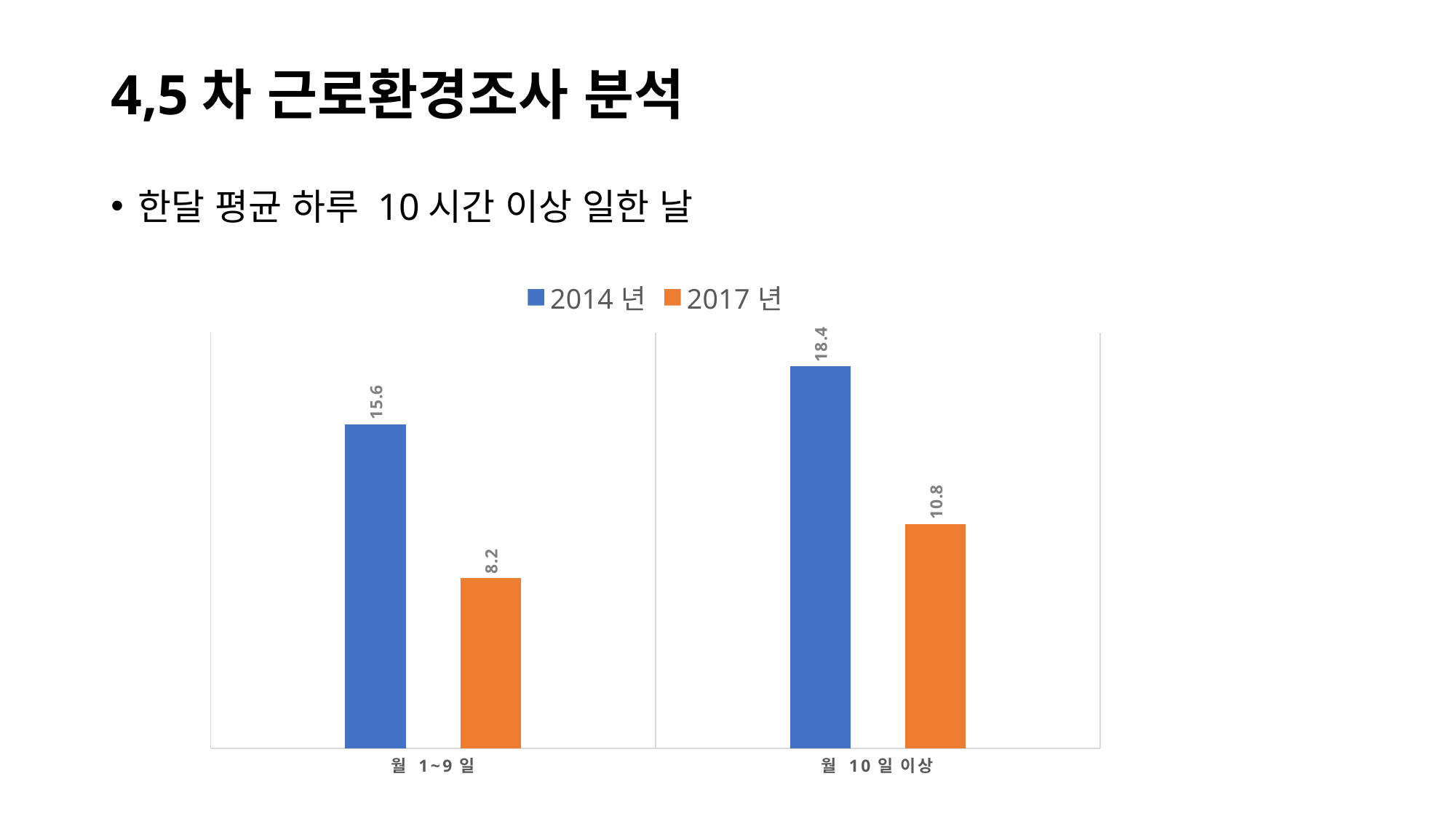
What is the difference between the 2014 년 and 2017 년 values in the 월 1~9 일 category? 7.4 What is the value for 2017 년 in the 월 10 일 이상 category? 10.8 How many series does the legend list? 2 What is the value for 2017 년 in the 월 1~9 일 category? 8.2 What kind of chart is shown on the slide? Bar chart How many categories are shown on the x axis? 2 What is the value for 2014 년 in the 월 10 일 이상 category? 18.4 Which is larger in the 월 10 일 이상 category, the 2014 년 value or the 2017 년 value? 2014 년 What is the difference between the 2014 년 and 2017 년 values in the 월 10 일 이상 category? 7.6 Which category has the highest value for 2014 년? 월 10 일 이상 What is the value for 2014 년 in the 월 1~9 일 category? 15.6 Which category has the lowest value for 2017 년? 월 1~9 일